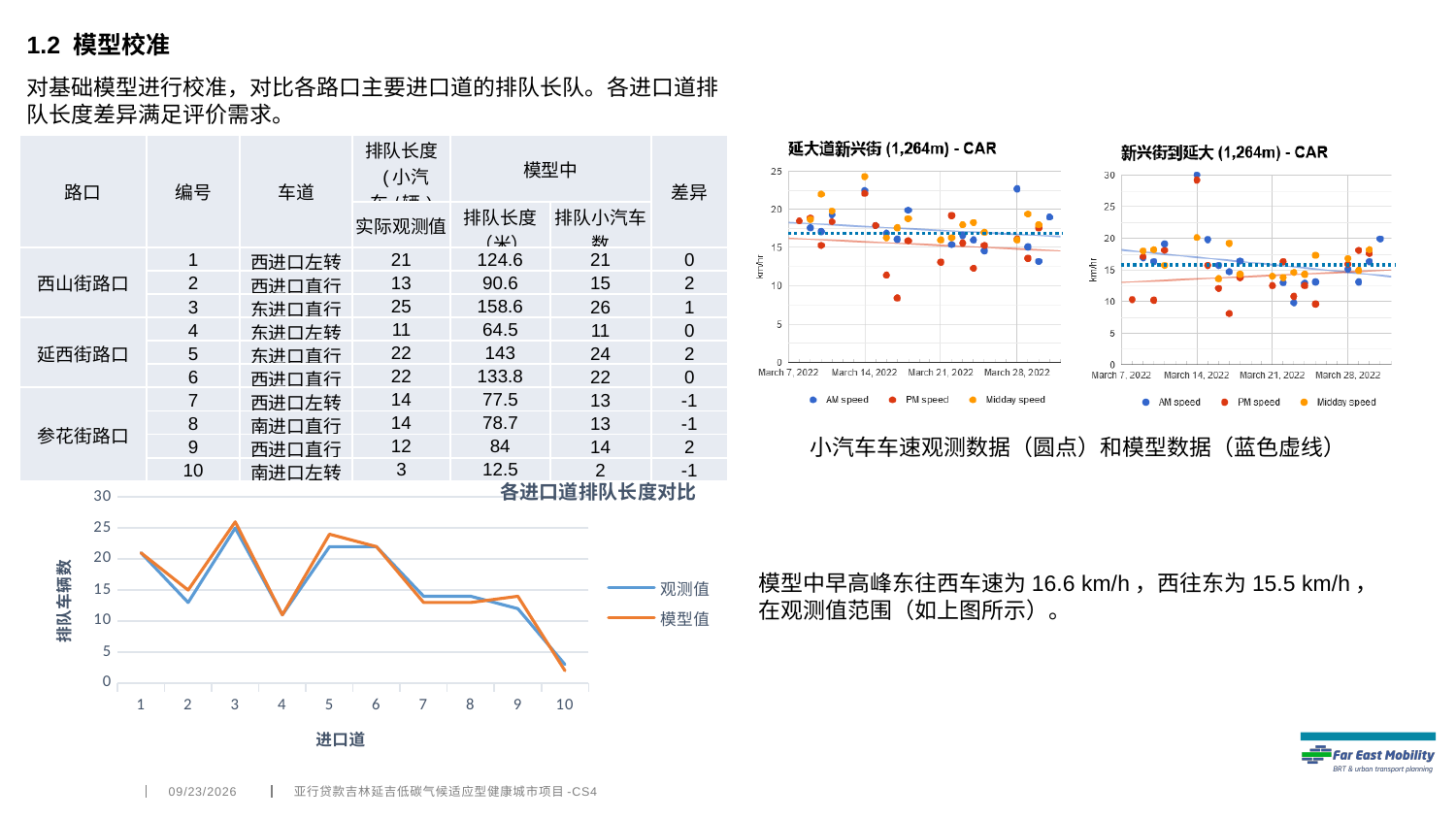
In the chart 各进口道排队长度对比, at 进口道 9, which series has the larger value, 观测值 or 模型值? 模型值 What are the legend entries of the chart titled 新兴街到延大 (1,264m) - CAR? AM speed, PM speed, Midday speed What kind of chart is the chart titled 各进口道排队长度对比? line chart What is the y-axis label of the chart titled 延大道新兴街 (1,264m) - CAR? km/hr In the chart titled 延大道新兴街 (1,264m) - CAR, how many series does the legend list? 3 In the chart 各进口道排队长度对比, how many 进口道 categories are plotted on the x axis? 10 In the chart 各进口道排队长度对比, do the 观测值 values generally rise or fall from 进口道 5 to 进口道 10? fall In the chart 各进口道排队长度对比, which 进口道 has the highest 观测值? 3 In the chart 各进口道排队长度对比, is the 观测值 for 进口道 2 greater or less than 15? less In the chart 各进口道排队长度对比, is the 模型值 for 进口道 5 greater or less than 20? greater In the chart 各进口道排队长度对比, how many series does the legend list? 2 In the chart 各进口道排队长度对比, which 进口道 has the lowest 模型值? 10